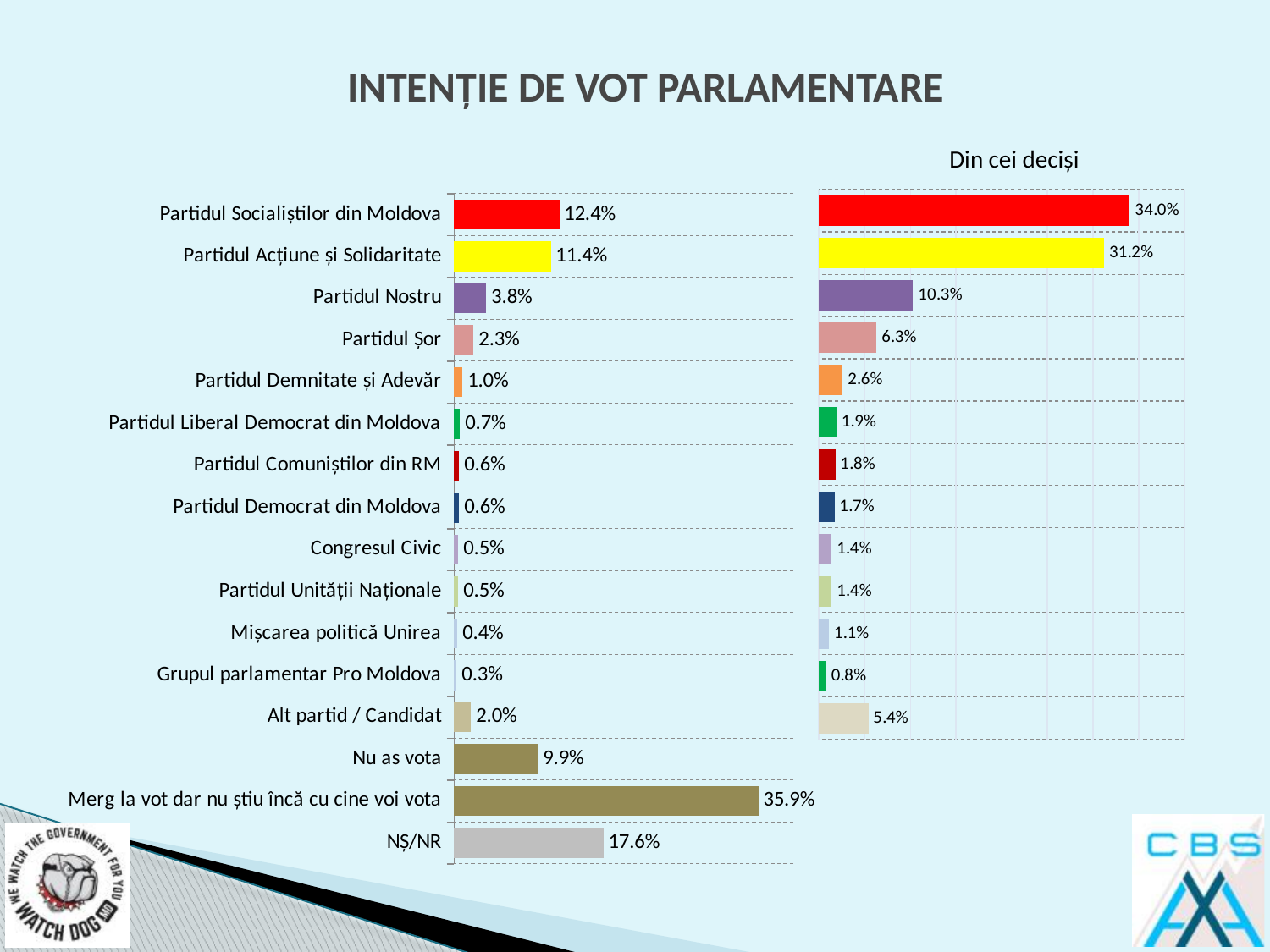
In the right chart (Din cei deciși), which category has the lowest value? Grupul parlamentar Pro Moldova How many categories are shown in the right chart (Din cei deciși)? 13 In the right chart (Din cei deciși), what is the difference between Partidul Socialiștilor din Moldova and Partidul Acțiune și Solidaritate? 2.8 percentage points In the right chart (Din cei deciși), what is the value for Partidul Șor? 6.3% How many categories are shown in the left chart? 16 In the left chart, what is the value for Alt partid / Candidat? 2.0% In the right chart (Din cei deciși), which party has the highest value? Partidul Socialiștilor din Moldova In the left chart, what is the value for Partidul Nostru? 3.8% In the left chart, which category has the highest value? Merg la vot dar nu știu încă cu cine voi vota What type of chart is used on this slide? Bar chart In the left chart, which is larger: Nu as vota or NȘ/NR? NȘ/NR What is the title shown above the right chart? Din cei deciși